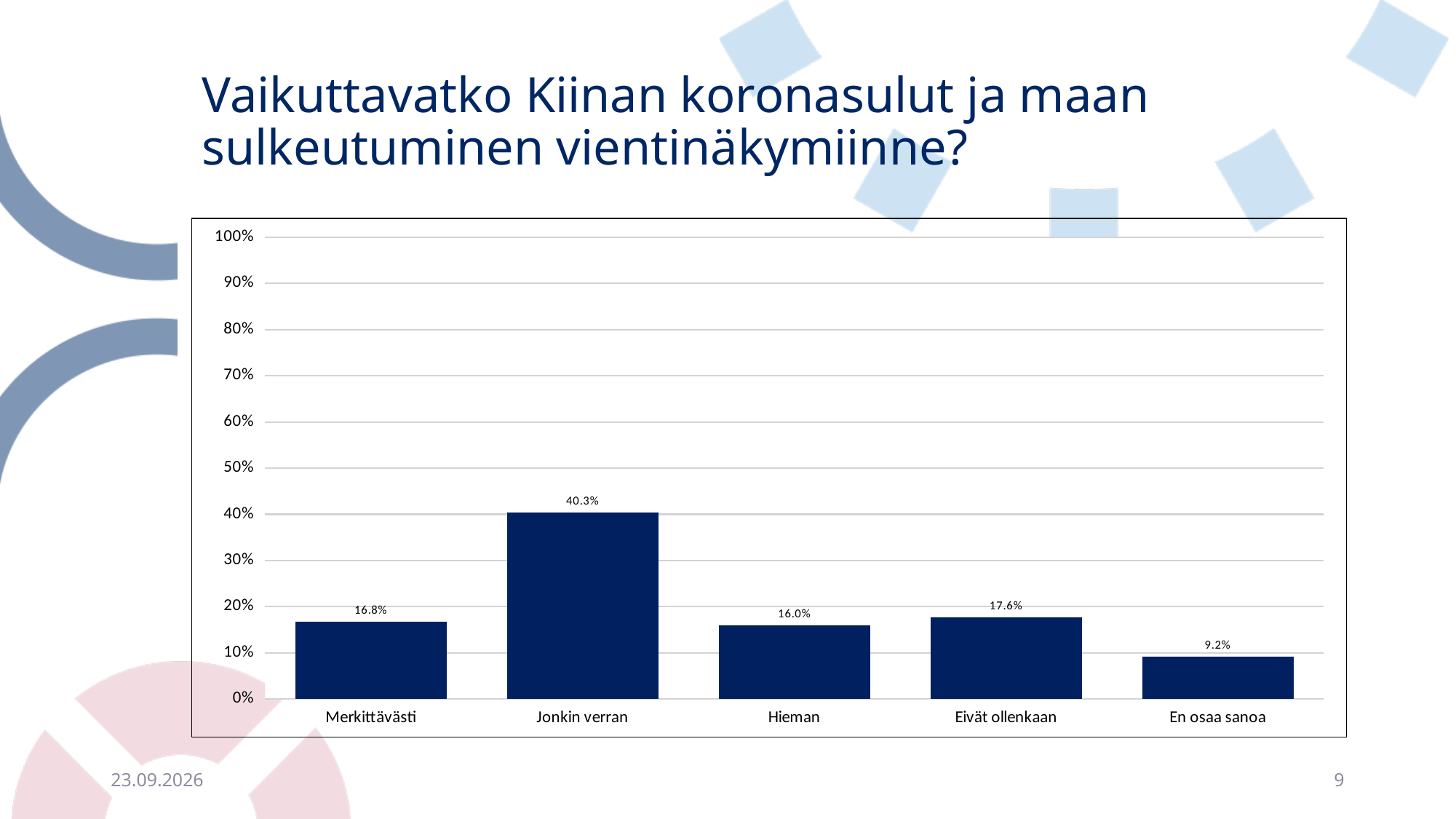
What is the value for Jonkin verran? 40.3% What is the value for Merkittävästi? 16.8% What is the value for En osaa sanoa? 9.2% Which is larger, the value for Eivät ollenkaan or the value for Merkittävästi? Eivät ollenkaan How many categories are shown on the x axis? 5 What is the highest value shown on the y axis? 100% What is the difference between the values for Jonkin verran and Hieman? 24.3% Which category has the highest value? Jonkin verran What kind of chart is shown on the slide? bar chart Which category has the lowest value? En osaa sanoa What is the value for Eivät ollenkaan? 17.6% Is the value for Jonkin verran greater or less than 50%? less